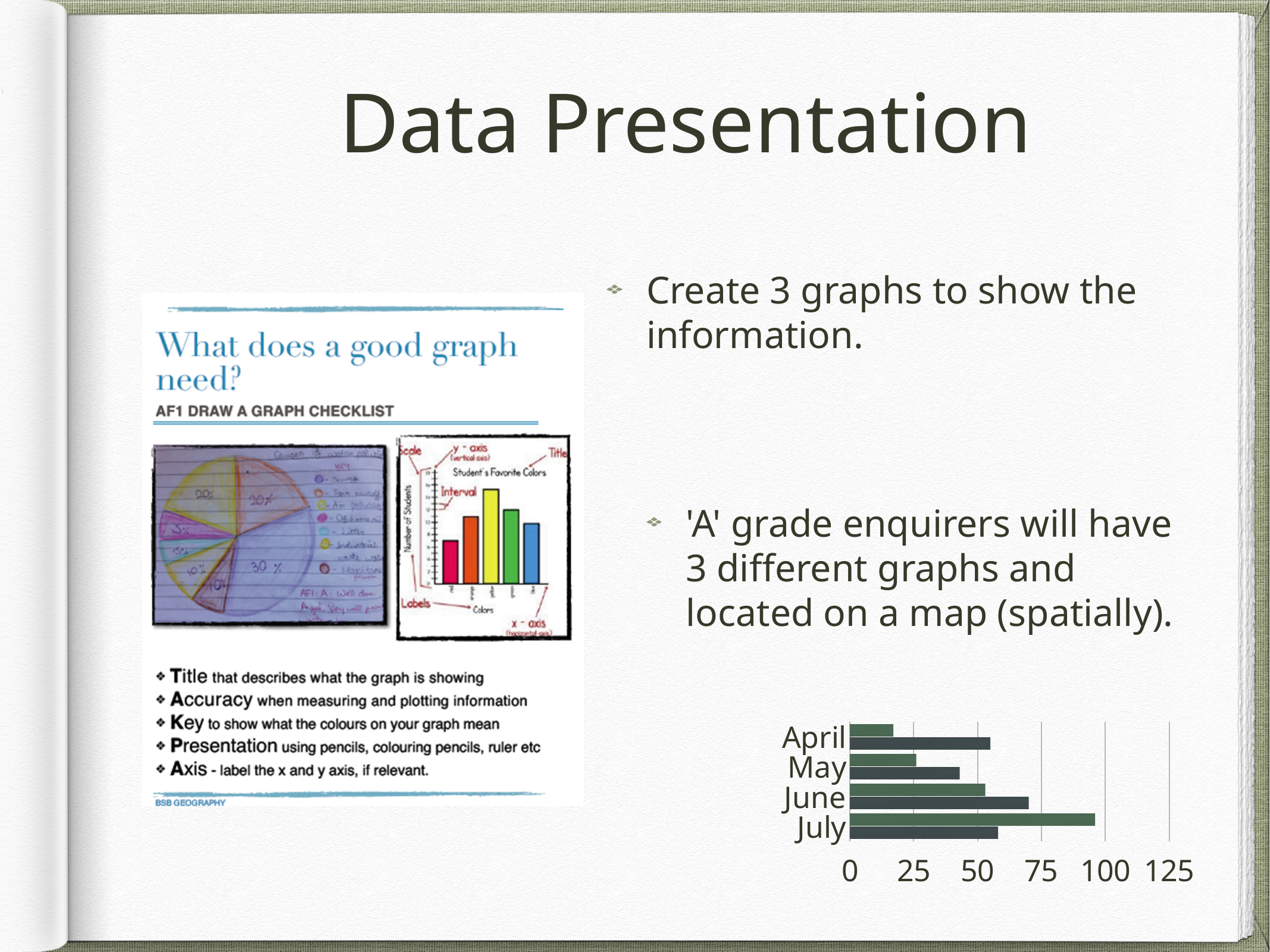
How many categories does the bar chart at the bottom right of the slide show? 4 In the bar chart at the bottom right, does the lighter green bar get longer or shorter from April to July? longer In the bar chart at the bottom right, which month has the shortest bar overall? April In the bar chart at the bottom right, is the value of the longer bar for July greater or less than 75? greater How many bars are drawn for each month in the bar chart at the bottom right of the slide? 2 In the bar chart at the bottom right, is the value of the longer bar for June greater or less than 50? greater In the bar chart at the bottom right, is the value of the shorter bar for April greater or less than 25? less What is the highest value labelled on the horizontal axis of the bar chart at the bottom right? 125 In the bar chart at the bottom right, which month has the longest bar overall? July In the bar chart at the bottom right, is the lighter green bar for July longer or shorter than the lighter green bar for April? longer What kind of chart is shown at the bottom right of the slide? bar chart